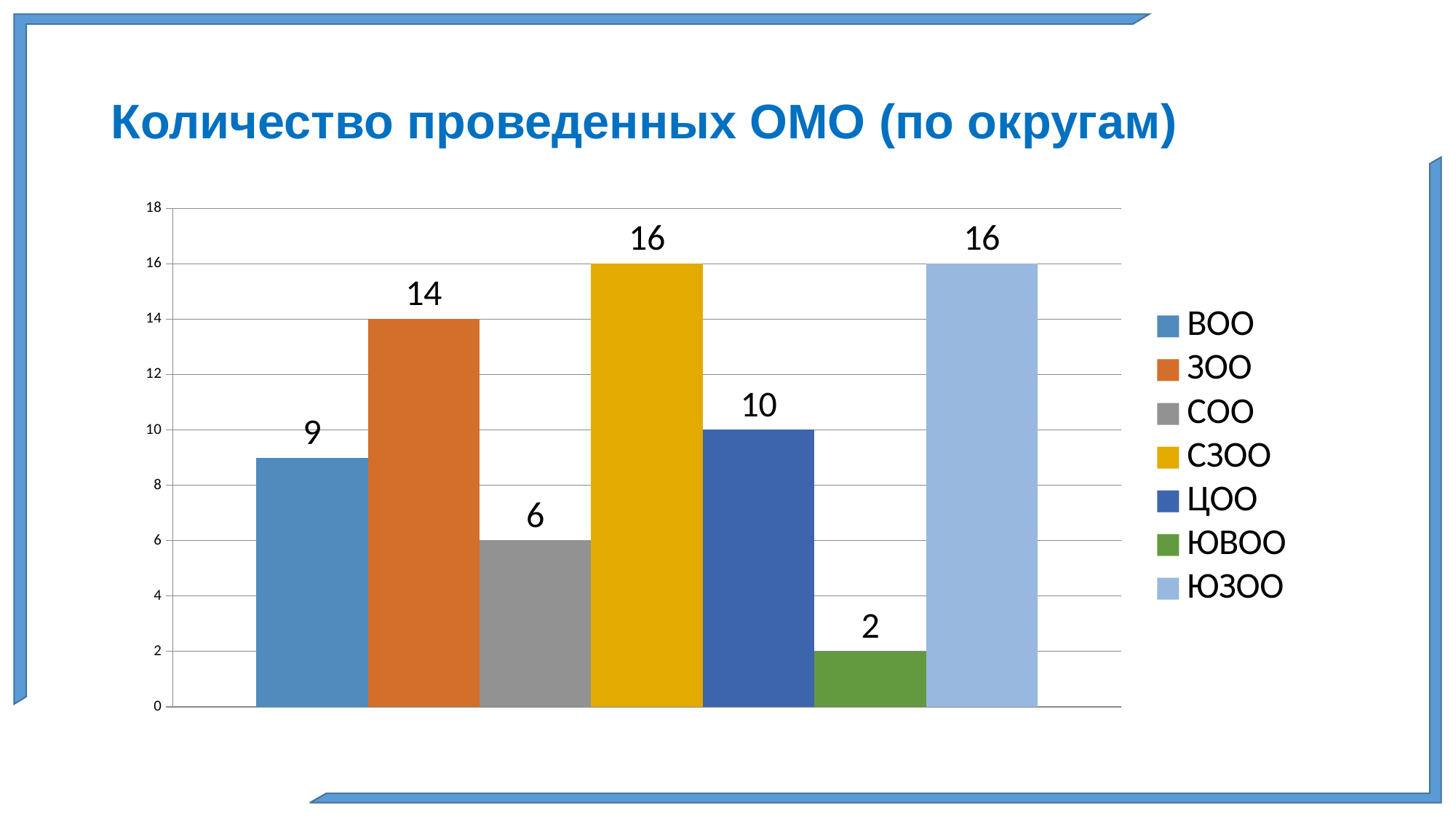
Which two series share the highest value? СЗОО and ЮЗОО What is the value for ЗОО? 14 What is the difference between the values for ЗОО and СОО? 8 Which series has the lowest value? ЮВОО What colour is the bar for СЗОО? Yellow How many series does the legend list? 7 What is the value for ЦОО? 10 What is the title of the slide? Количество проведенных ОМО (по округам) What is the value for ВОО? 9 Which is larger, the value for ВОО or the value for ЦОО? ЦОО What kind of chart is shown on the slide? Bar chart What is the value for ЮВОО? 2